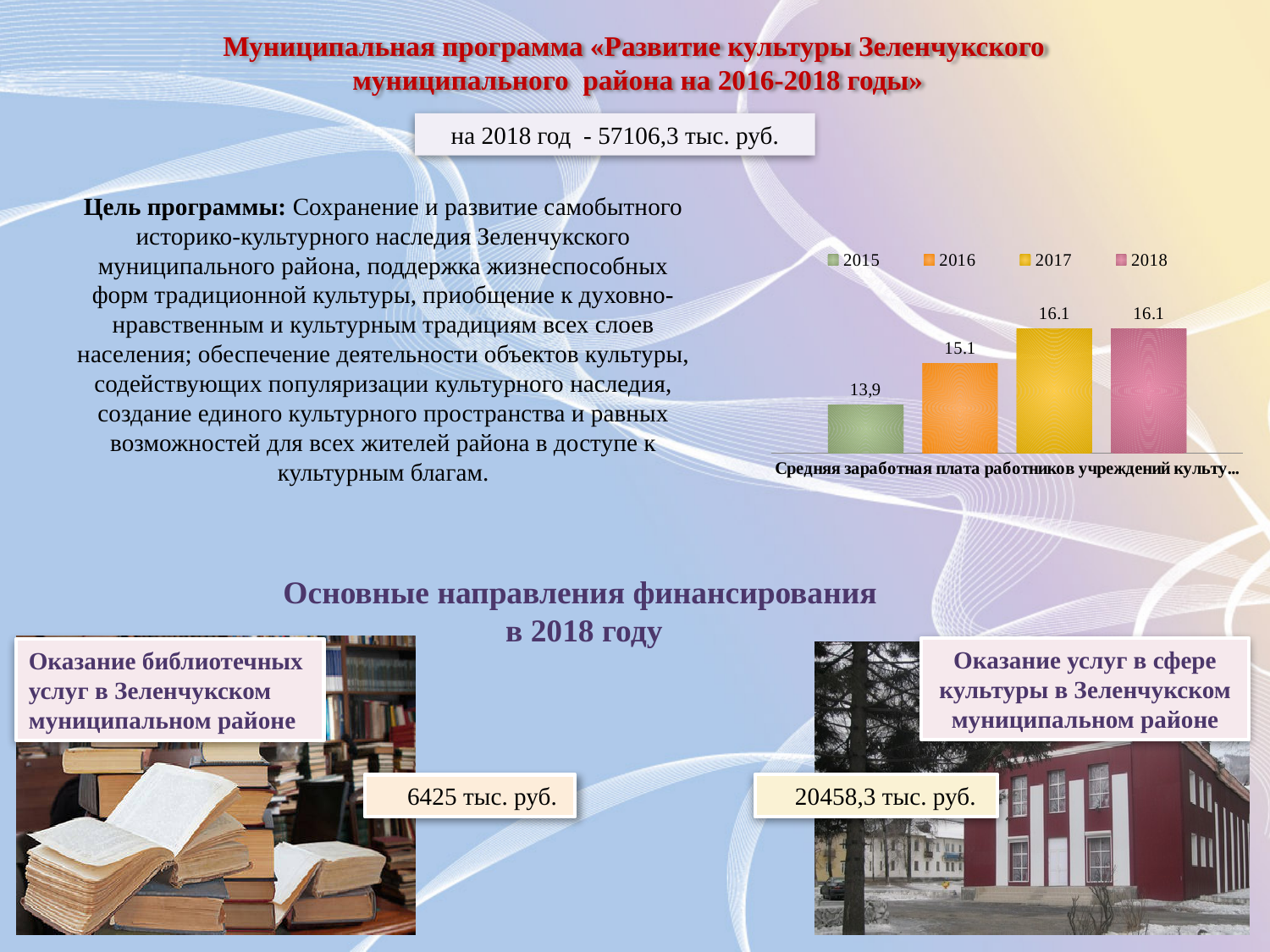
Which year has the lowest value in the chart? 2015 How many entries does the chart legend list? 4 Which is larger in the chart, the value for 2016 or the value for 2015? 2016 What is the difference between the values for 2017 and 2016 in the chart? 1.0 What is the difference between the values for 2016 and 2015 in the chart? 1.2 What is the value shown for 2017 in the chart? 16.1 What is the value shown for 2015 in the chart? 13,9 How many bars are plotted in the chart? 4 Do the values in the chart rise or fall from 2015 to 2018? rise What type of chart is shown on the slide? bar chart What is the value shown for 2018 in the chart? 16.1 What is the value shown for 2016 in the chart? 15.1